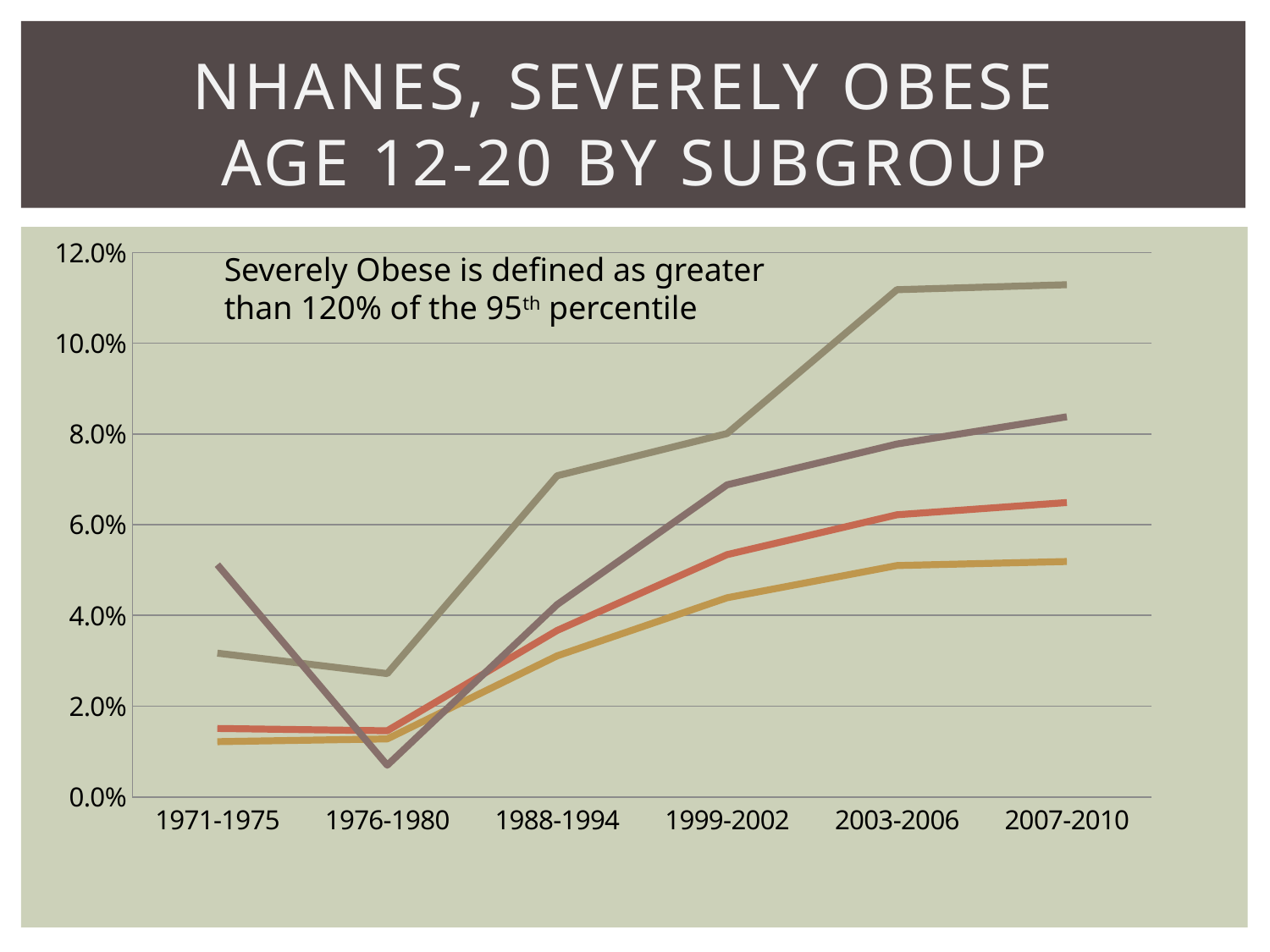
Is the value of the grey line for 1988-1994 greater or less than 6.0%? greater What kind of chart is shown on the slide? line chart According to the text on the chart, how is Severely Obese defined? greater than 120% of the 95th percentile Is the value of the lowest (gold) line for 2007-2010 greater or less than 6.0%? less Is the value of the topmost (grey) line for 2007-2010 greater or less than 10.0%? greater How many lines are plotted on the chart? 4 At 2007-2010, which is higher, the red line or the gold line? the red line How many survey periods are shown along the x axis? 6 In which period does the purple line reach its lowest value? 1976-1980 Do the values of the grey line rise or fall from 1988-1994 to 2007-2010? rise